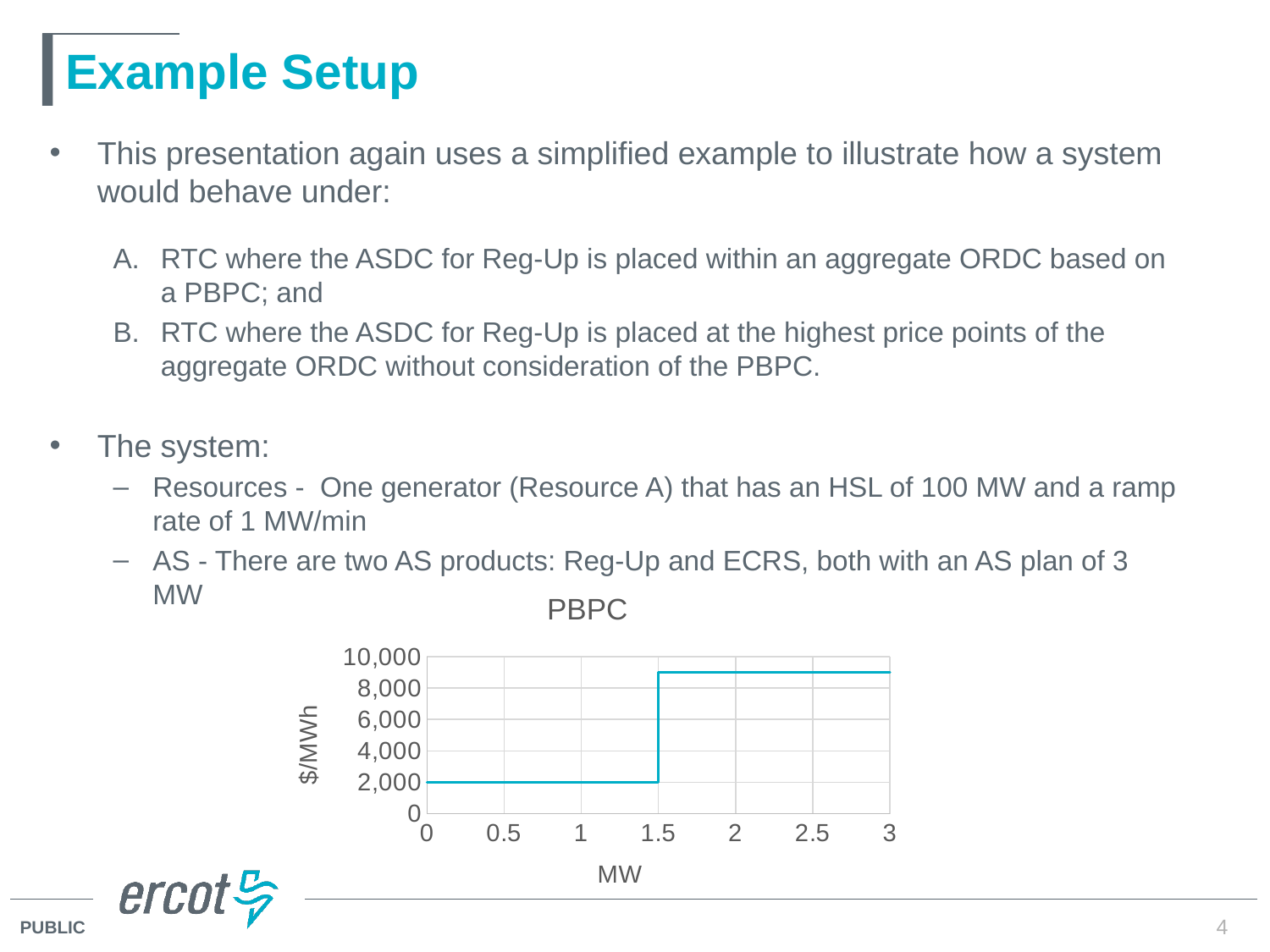
What is the value of the PBPC line at 0.5 MW? 2,000 What is the highest value shown on the y axis of the chart? 10,000 What is the title of the chart? PBPC What is the value of the PBPC line at 1 MW? 2,000 Does the PBPC line rise or fall as MW increases along the x axis? rise Is the value of the PBPC line at 1 MW greater or less than 4,000? less Is the value of the PBPC line at 2.5 MW greater or less than 10,000? less What kind of chart is shown on the slide? line chart At what MW value does the PBPC line step up from its lower level to its higher level? 1.5 Is the value of the PBPC line at 2 MW greater or less than 8,000? greater What is the label of the y axis of the chart? $/MWh Which is larger, the value of the PBPC line at 0.5 MW or at 2.5 MW? 2.5 MW